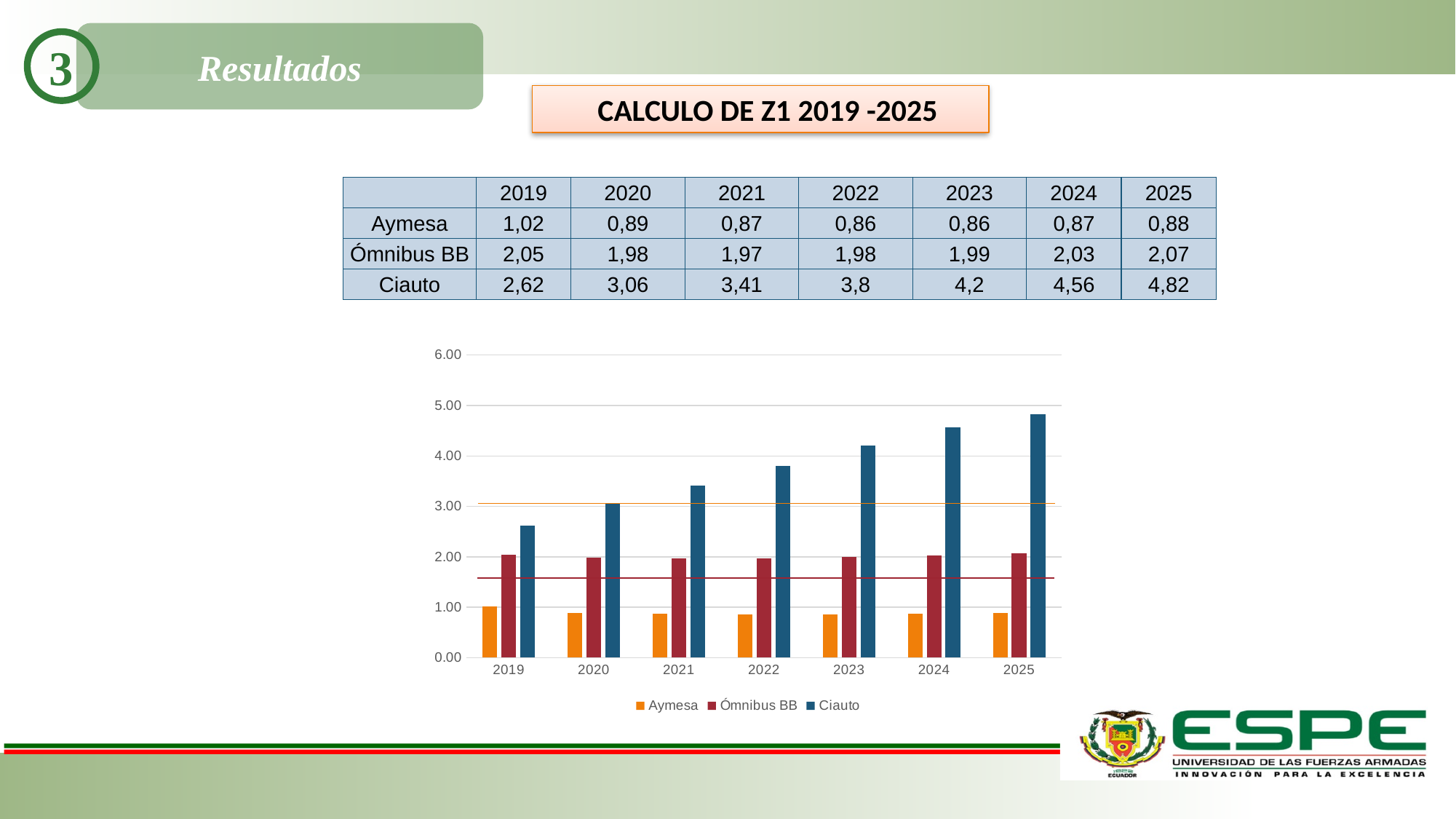
Which series has the highest value in 2025? Ciauto What is the difference between the Ciauto values for 2025 and 2019? 2,2 What is the value for Ómnibus BB in 2023? 1,99 Do the Ciauto values rise or fall from 2019 to 2025? rise How many years are shown on the x axis of the chart? 7 Which is larger, the Ciauto value in 2021 or the Ómnibus BB value in 2021? Ciauto value in 2021 How many series does the chart legend list? 3 Which series has the lowest value in 2022? Aymesa Is the value for Ciauto in 2024 greater or less than 4.00? greater What kind of chart is shown on the slide? bar chart What is the value for Aymesa in 2019? 1,02 What is the value for Ciauto in 2025? 4,82